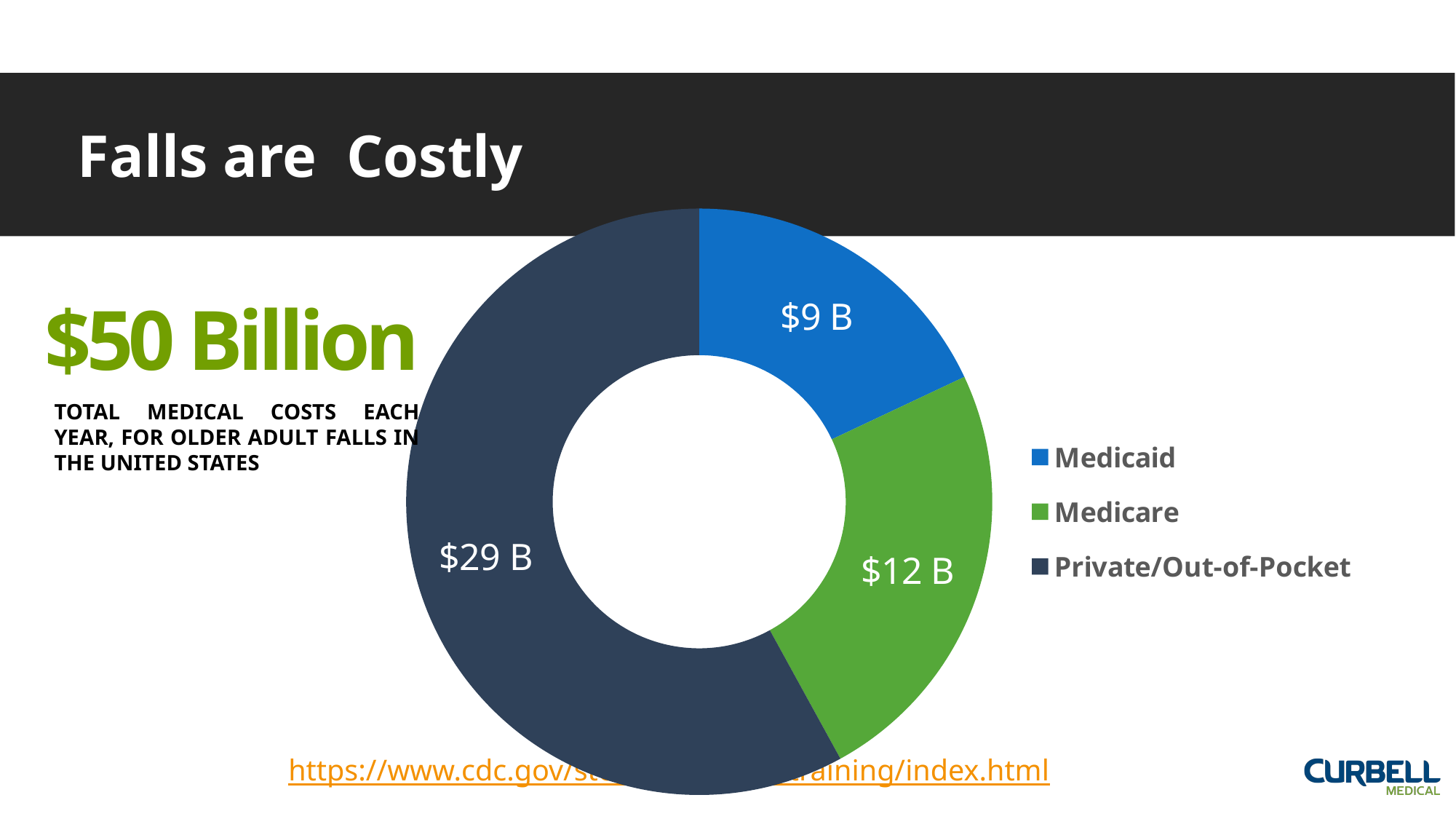
What colour is the Medicare slice? Green Which category has the largest value? Private/Out-of-Pocket What is the difference between the Medicare value and the Medicaid value? $3 B How many categories does the chart show? 3 Which is larger, Medicare or Medicaid? Medicare What is the difference between the Private/Out-of-Pocket value and the Medicare value? $17 B What is the value for Medicare? $12 B What kind of chart is shown on the slide? Doughnut chart What is the value for Medicaid? $9 B What is the total of all three slices? $50 B Which category has the smallest value? Medicaid What is the value for Private/Out-of-Pocket? $29 B